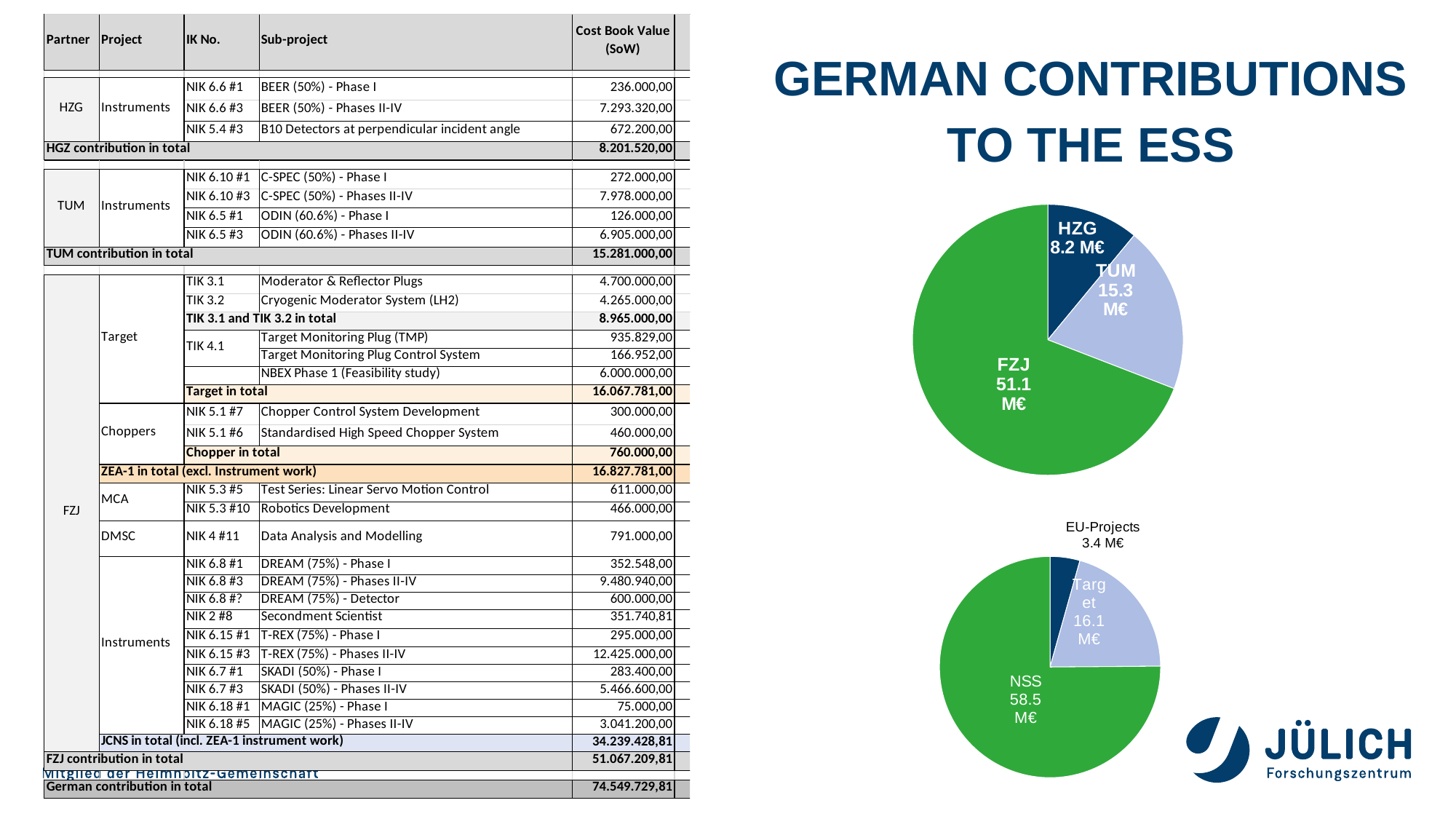
In the top pie chart, how many slices are there? 3 In the top pie chart, what is the difference between the FZJ and TUM values? 35.8 M€ In the bottom pie chart, which is larger, Target or NSS? NSS In the bottom pie chart, which category has the smallest slice? EU-Projects In the top pie chart, what is the value for HZG? 8.2 M€ What type of chart is used on the right side of the slide? Pie chart In the top pie chart, which partner has the smallest slice? HZG In the top pie chart, what is the value for FZJ? 51.1 M€ In the top pie chart, which partner has the largest slice? FZJ In the top pie chart, what is the value for TUM? 15.3 M€ In the bottom pie chart, what is the value for EU-Projects? 3.4 M€ In the bottom pie chart, what is the value for NSS? 58.5 M€